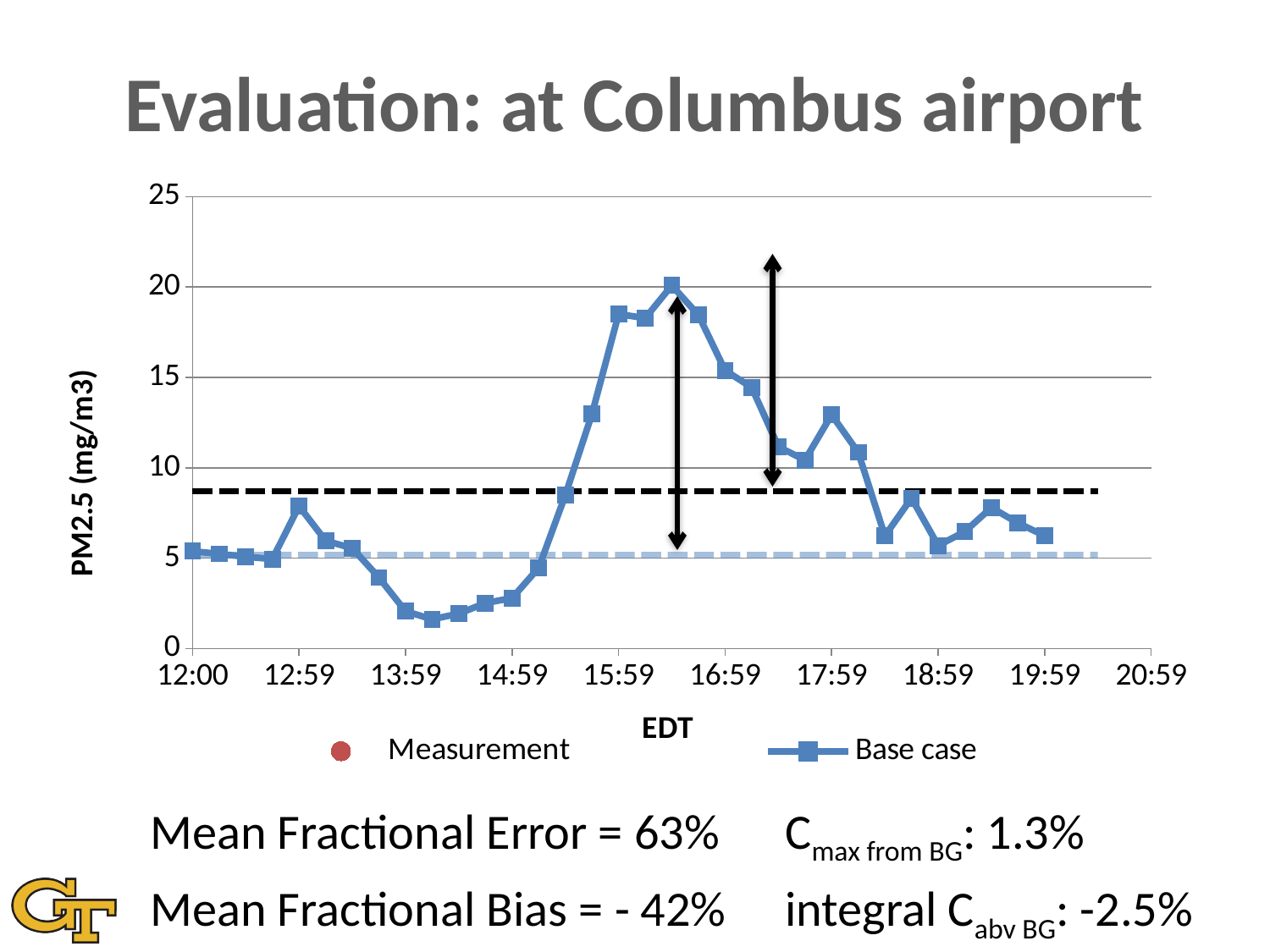
Is the Base case value at 12:00 greater or less than 10? less What are the two series named in the legend? Measurement and Base case How many time labels are shown on the x axis? 10 Is the Base case value at 15:59 greater or less than 15? greater Is the Base case value at 13:59 greater or less than 5? less What kind of chart is shown on the slide? Line chart Does the Base case series rise or fall between 13:59 and 15:59? rise What is the label of the y axis? PM2.5 (mg/m3) How many series does the legend list? 2 Which is larger for the Base case series, the value at 15:59 or the value at 13:59? 15:59